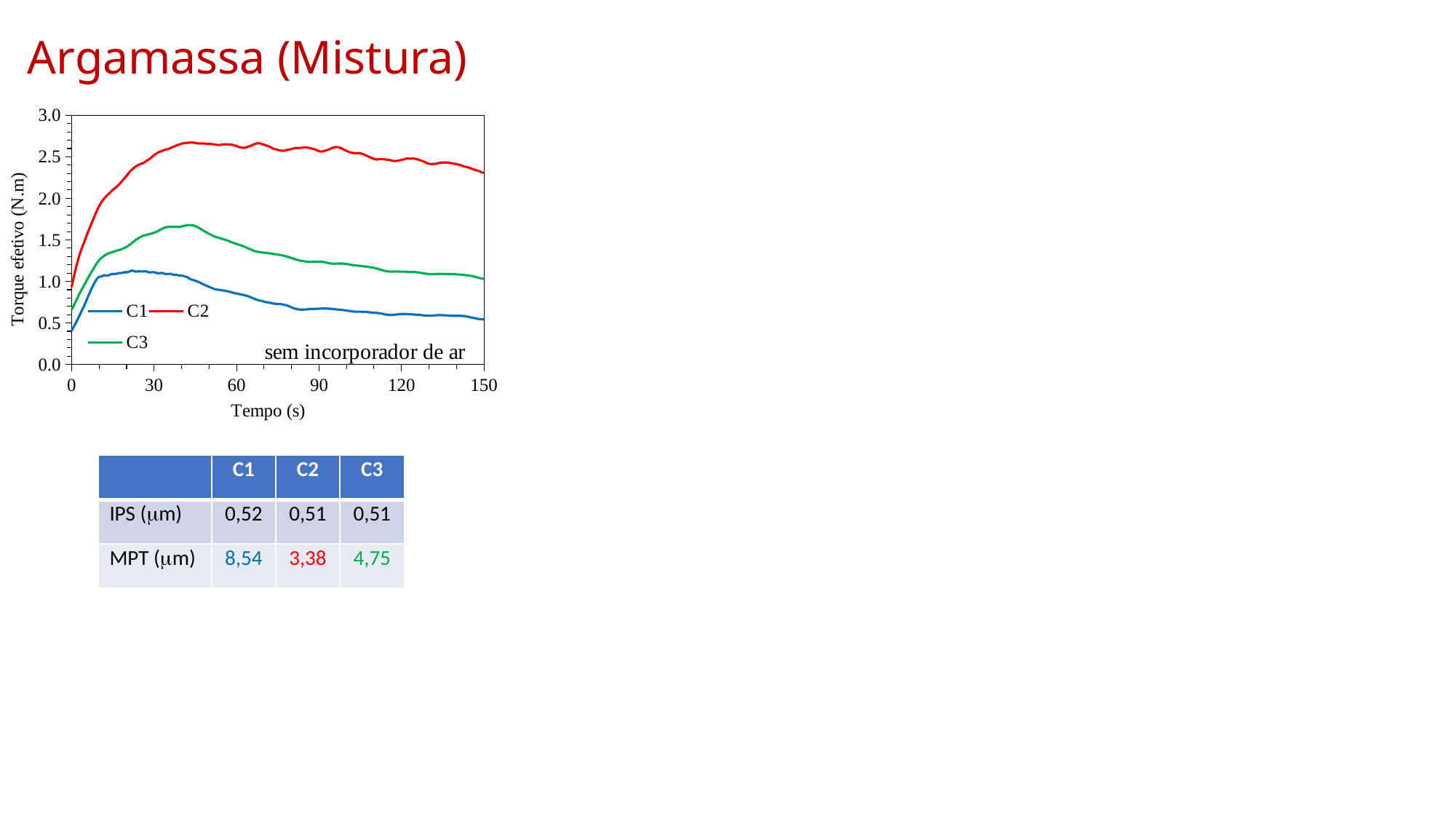
What text annotation appears inside the chart's plot area? sem incorporador de ar What is the label of the y axis of the chart? Torque efetivo (N.m) Which series has the lowest torque values throughout the chart? C1 Is the value for C3 at 90 s greater or less than 1.5? less How many series does the chart's legend list? 3 Does the C1 series rise or fall between 30 s and 150 s? fall Is the value for C2 at 150 s greater or less than 2.0? greater Is the peak value of C2 greater or less than 2.5? greater Which series has the larger value at 120 s, C2 or C3? C2 What kind of chart is shown on the slide? line chart Which series reaches the highest torque value in the chart? C2